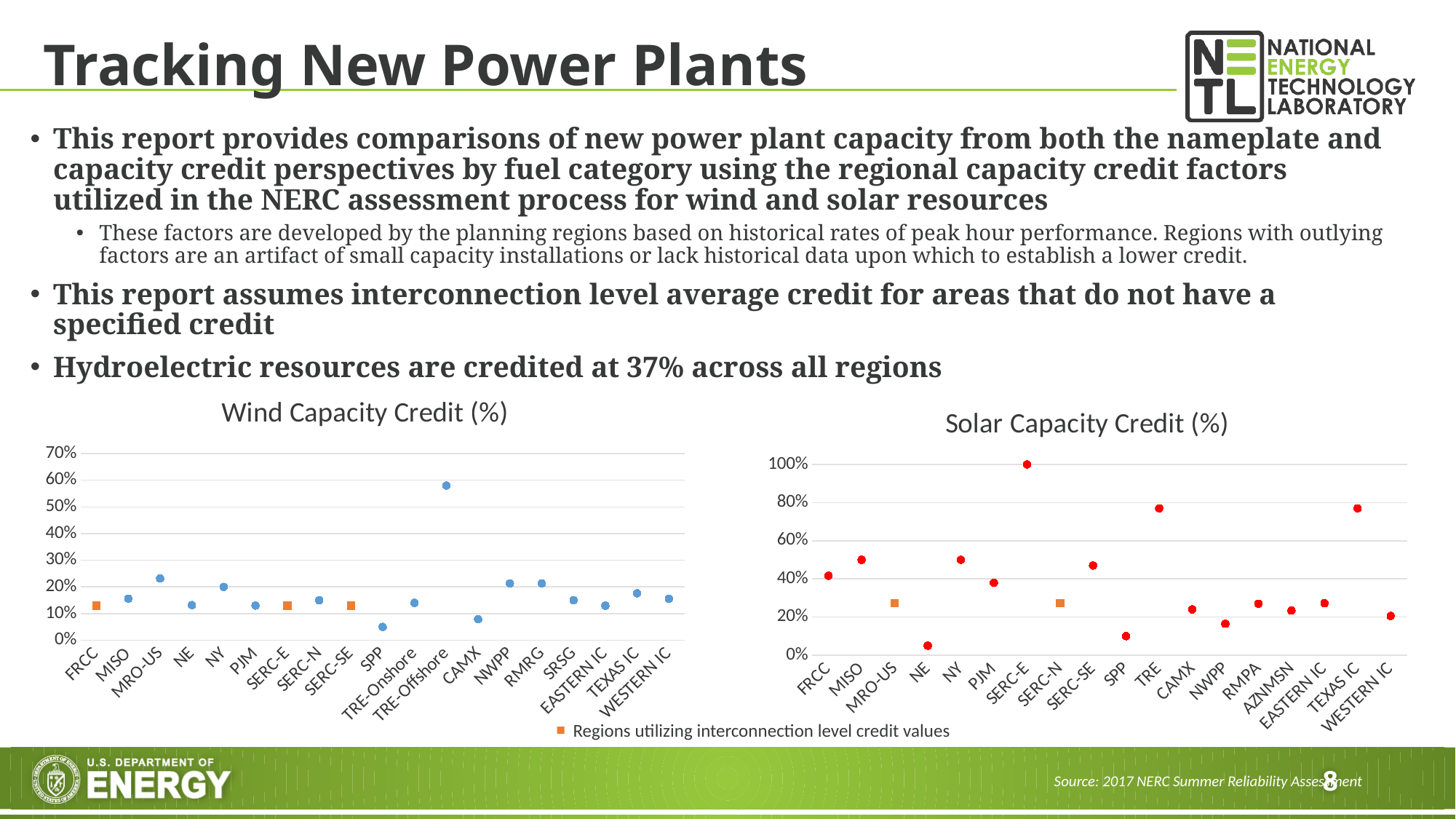
What do the orange square markers represent according to the legend below the charts? Regions utilizing interconnection level credit values In the Wind Capacity Credit (%) chart, is the value for SPP greater or less than 10%? less In the Solar Capacity Credit (%) chart, which region has the lowest value? NE In the Wind Capacity Credit (%) chart, which region has the lowest value? SPP In the Solar Capacity Credit (%) chart, which region has the highest value? SERC-E How many regions are plotted on the x axis of the Solar Capacity Credit (%) chart? 18 What kind of chart is the Wind Capacity Credit (%) chart? scatter chart In the Wind Capacity Credit (%) chart, which region has the highest value? TRE-Offshore In the Solar Capacity Credit (%) chart, is the value for TRE greater or less than 60%? greater In the Wind Capacity Credit (%) chart, is the value for TRE-Offshore greater or less than 50%? greater In the Wind Capacity Credit (%) chart, which is larger, the value for MRO-US or the value for NE? MRO-US How many regions are plotted on the x axis of the Wind Capacity Credit (%) chart? 19